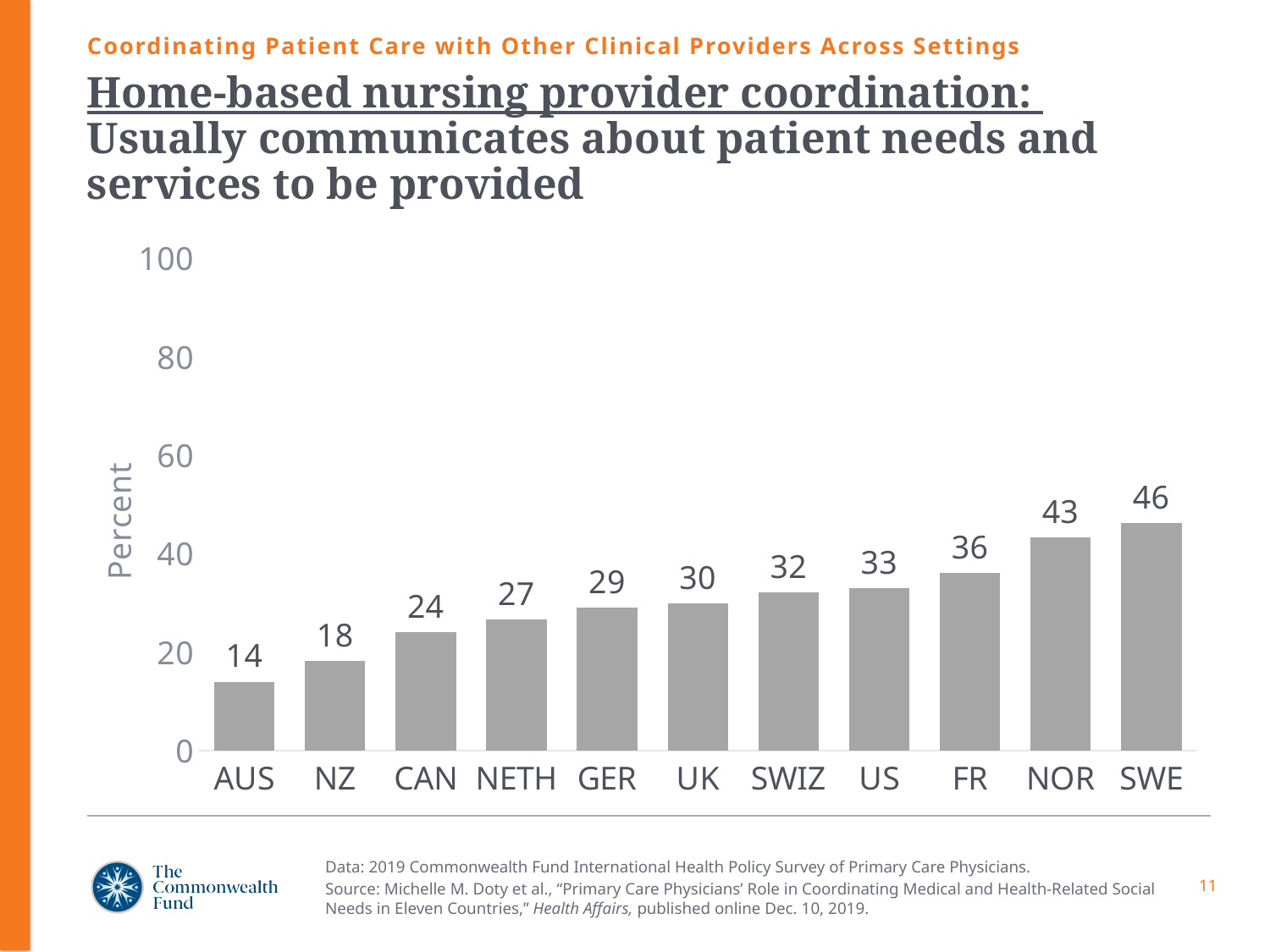
What is the value for US? 33 Which country has the highest value? SWE What is the difference between the values for FR and CAN? 12 How many countries are shown on the chart? 11 What is the difference between the values for NOR and AUS? 29 Is the value for SWIZ greater or less than 40? less What is the value for SWE? 46 What kind of chart is shown on the slide? bar chart What is the value for NETH? 27 Which country has the lowest value? AUS Which is larger, the value for GER or the value for NZ? GER Do the values rise or fall from left to right along the x axis? rise